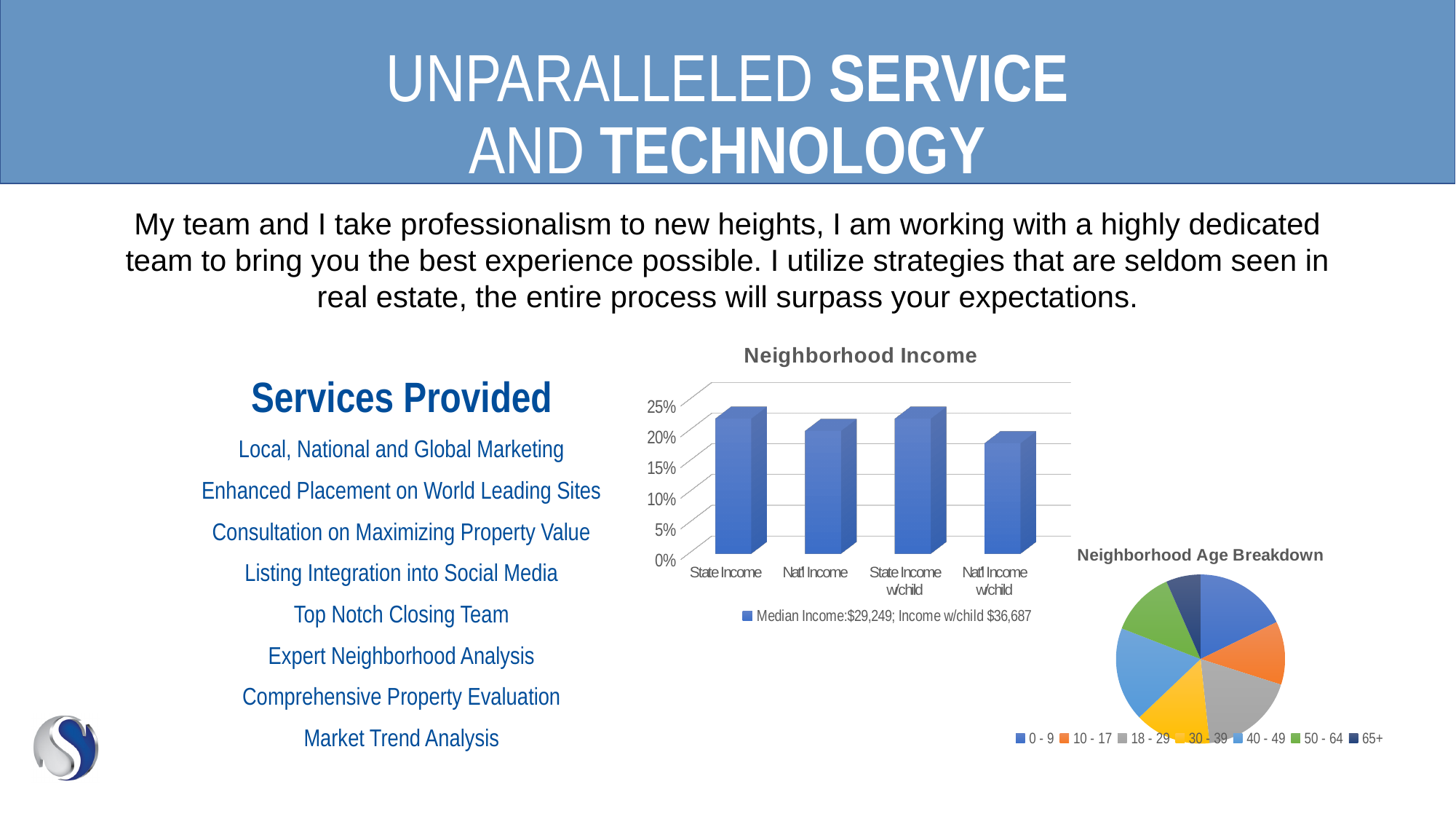
What is the title of the pie chart on the slide? Neighborhood Age Breakdown What kind of chart is the Neighborhood Income chart? bar chart In the Neighborhood Income chart, is the value for Nat'l Income greater or less than 25%? less How many categories are shown on the x axis of the Neighborhood Income chart? 4 In the Neighborhood Age Breakdown chart, which age group has the smallest slice? 65+ In the Neighborhood Income chart, which category has the lowest value? Nat'l Income w/child What kind of chart is the Neighborhood Age Breakdown chart? pie chart In the Neighborhood Income chart, which is larger: State Income or Nat'l Income w/child? State Income In the Neighborhood Income chart, is the value for State Income greater or less than 20%? greater What is the legend entry shown below the Neighborhood Income chart? Median Income:$29,249; Income w/child $36,687 How many age groups does the legend of the Neighborhood Age Breakdown chart list? 7 In the Neighborhood Income chart, is the value for Nat'l Income w/child greater or less than 15%? greater